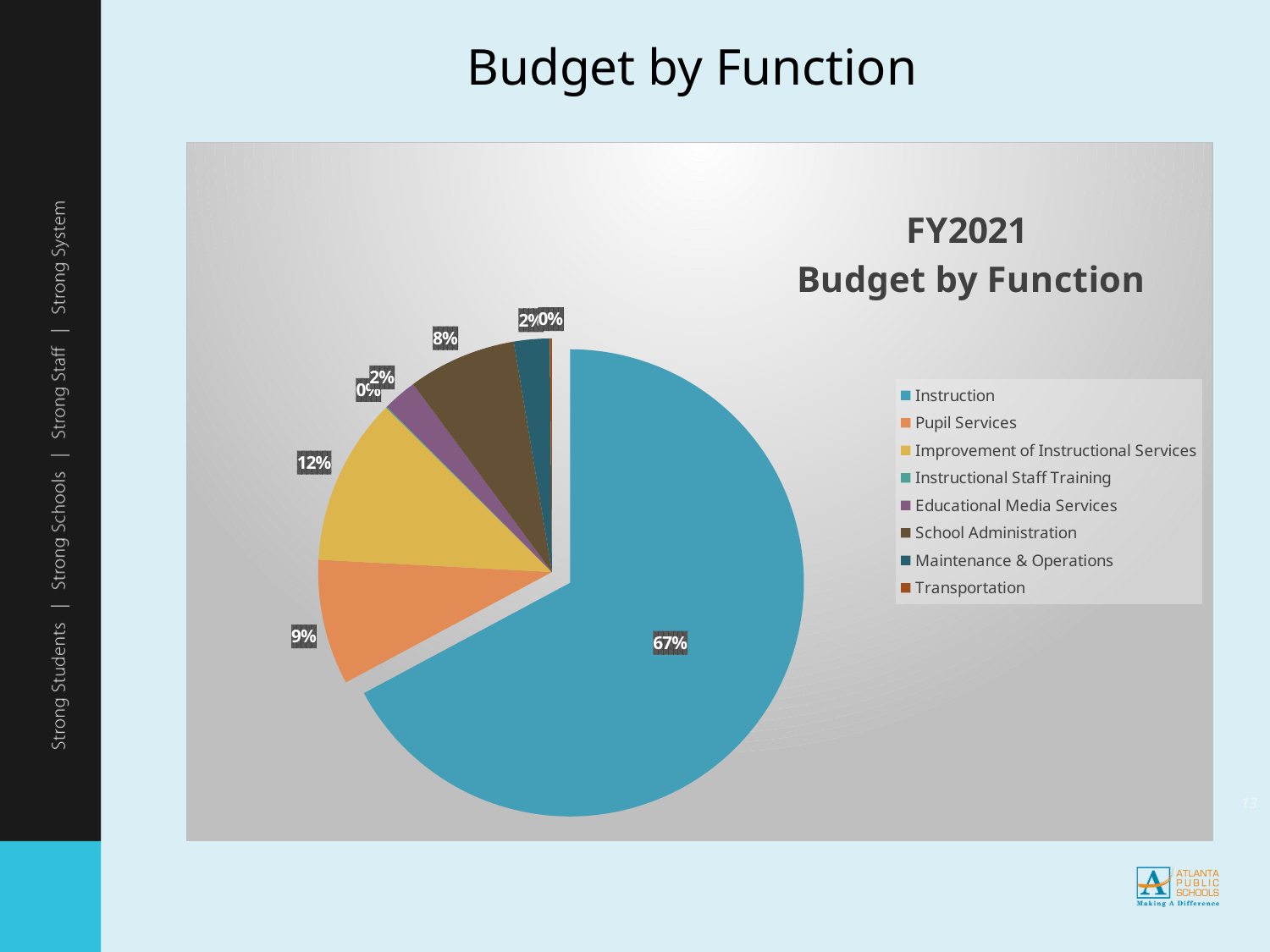
What share of the budget goes to Pupil Services? 9% What share of the budget goes to Instruction? 67% How many categories does the legend list? 8 Which legend entry is shown in orange? Pupil Services Which is larger, the share for Pupil Services or the share for Improvement of Instructional Services? Improvement of Instructional Services What is the title of the chart? FY2021 Budget by Function Which function has the largest share of the budget? Instruction What is the difference in percentage points between the Instruction share and the Improvement of Instructional Services share? 55 What kind of chart is shown on the slide? pie chart What share of the budget goes to Improvement of Instructional Services? 12%